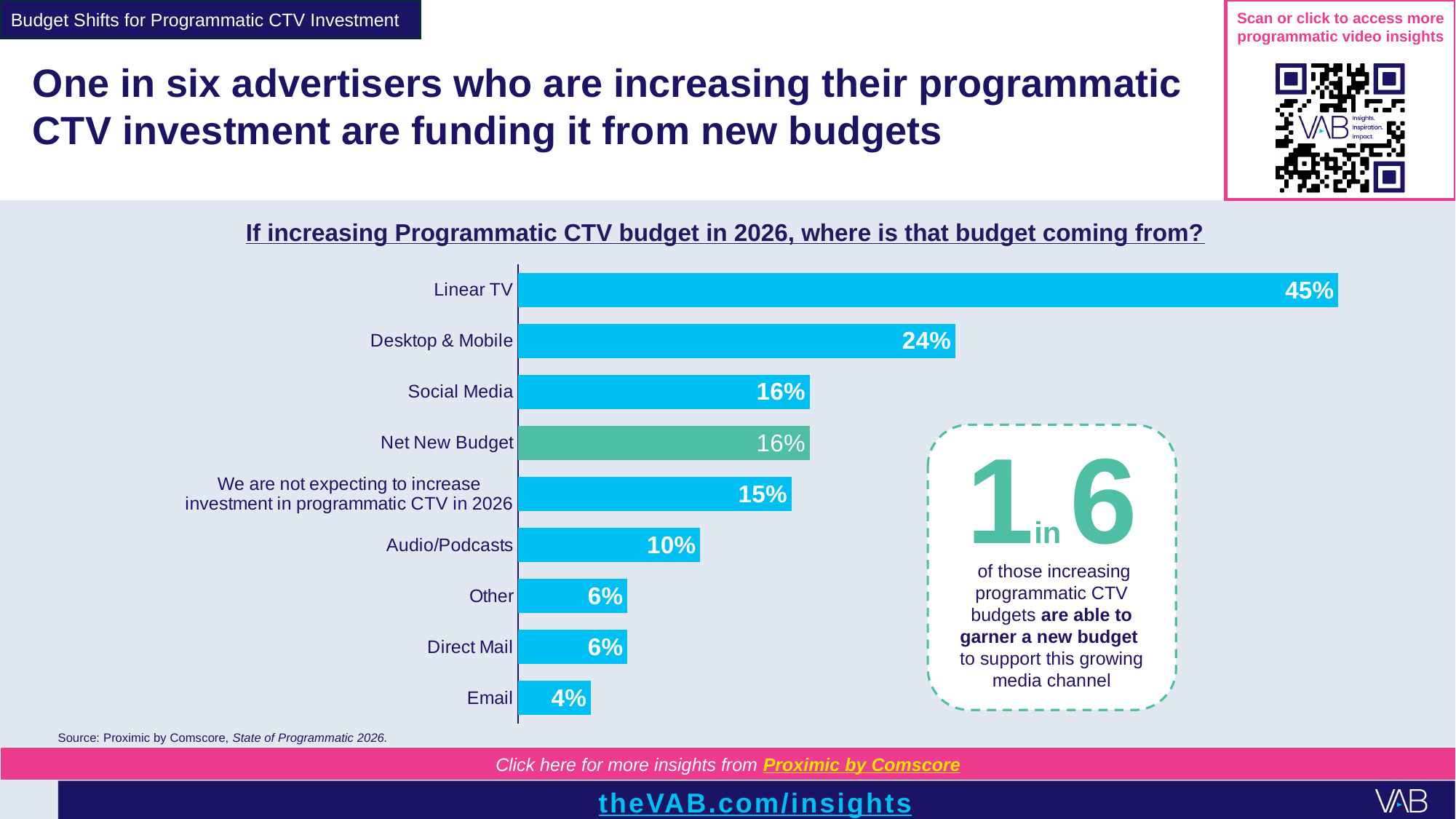
Which is larger, the value for Desktop & Mobile or the value for Social Media? Desktop & Mobile What is the title of the chart? If increasing Programmatic CTV budget in 2026, where is that budget coming from? What is the difference between the values for Social Media and Email? 12% Which category has the highest value in the chart? Linear TV What is the value shown for Audio/Podcasts? 10% What type of chart is shown on the slide? Bar chart What is the value shown for Net New Budget? 16% What percentage of advertisers say their increased programmatic CTV budget is coming from Linear TV? 45% Which bar in the chart is coloured green rather than blue? Net New Budget Which category has the lowest value in the chart? Email How many categories are shown in the bar chart? 9 What is the difference between the values for Linear TV and Desktop & Mobile? 21%